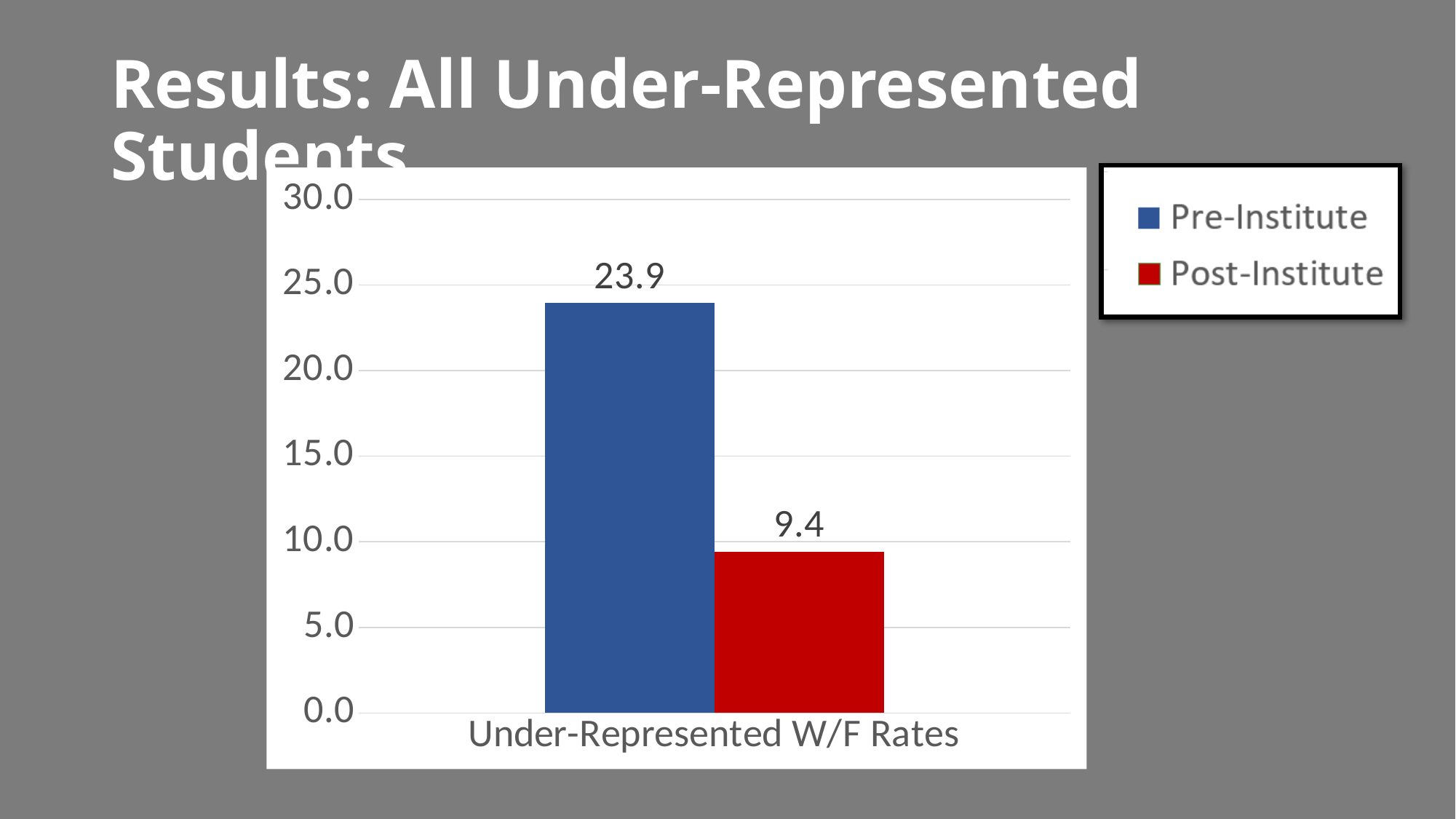
How many categories are shown on the x axis? 1 What is the Post-Institute value for Under-Represented W/F Rates? 9.4 How many series does the legend list? 2 What is the difference between the Pre-Institute and Post-Institute values? 14.5 Which series has the higher value for Under-Represented W/F Rates, Pre-Institute or Post-Institute? Pre-Institute What is the label of the category on the x axis? Under-Represented W/F Rates Which series has the lowest value on the chart? Post-Institute What is the Pre-Institute value for Under-Represented W/F Rates? 23.9 What colour is the Post-Institute bar? Red Is the Post-Institute value greater or less than 10.0? less What kind of chart is shown on the slide? Bar chart Is the Pre-Institute value greater or less than 20.0? greater